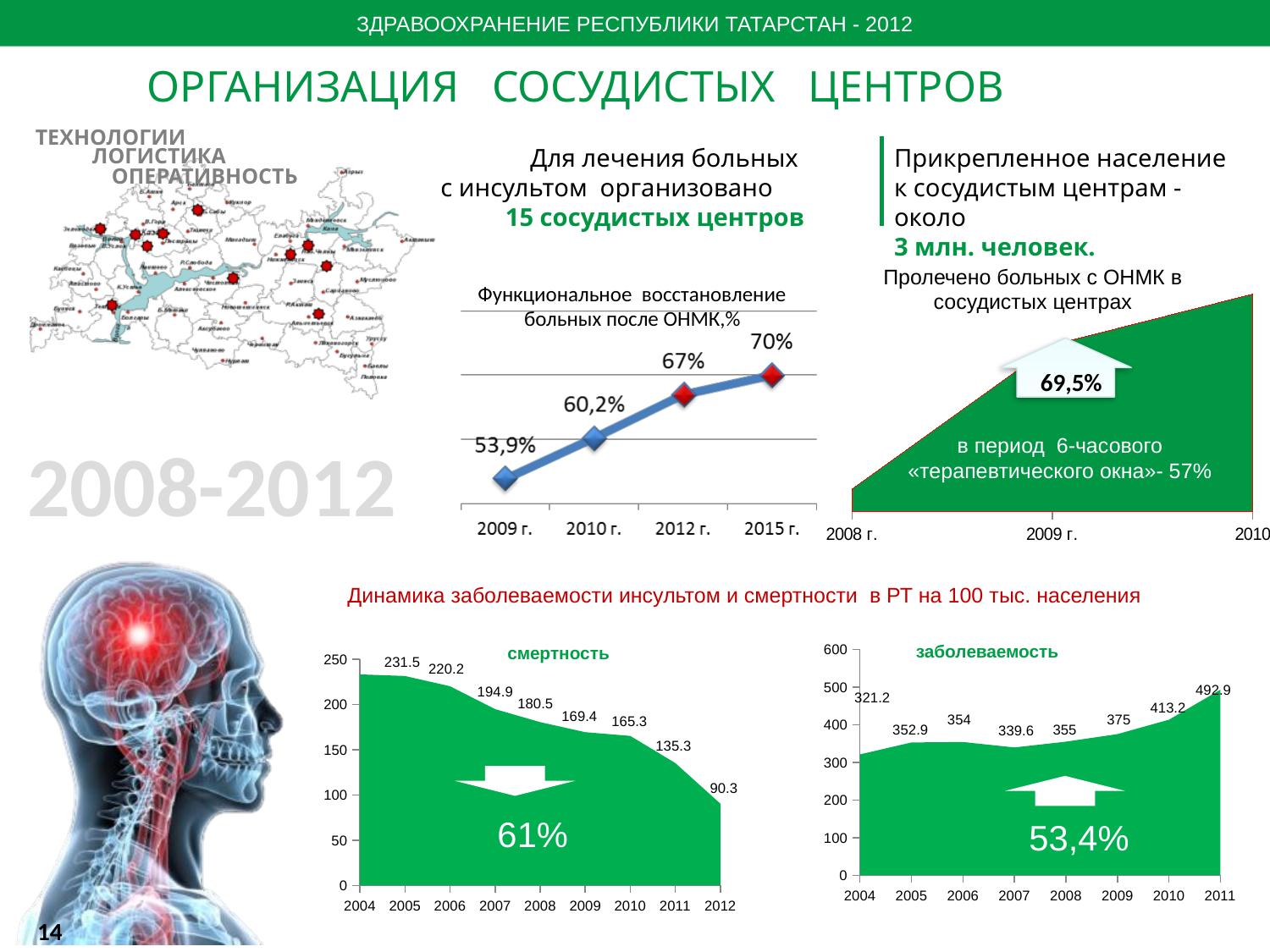
In the 'смертность' chart, what is the value for 2012? 90.3 In the 'заболеваемость' chart, what is the difference between the values for 2011 and 2010? 79.7 In the chart 'Функциональное восстановление больных после ОНМК,%', how many data points are plotted? 4 In the 'заболеваемость' chart, what is the value for 2011? 492.9 In the chart 'Функциональное восстановление больных после ОНМК,%', do the values rise or fall from 2009 г. to 2015 г.? rise In the 'заболеваемость' chart, which year has the highest value? 2011 In the chart 'Функциональное восстановление больных после ОНМК,%', what is the value for 2009 г.? 53,9% In the chart 'Функциональное восстановление больных после ОНМК,%', what kind of chart is it? line chart In the 'смертность' chart, what is the lowest labelled value? 90.3 In the 'заболеваемость' chart, what is the value for 2004? 321.2 In the 'смертность' chart, do the values rise or fall along the x axis from 2004 to 2012? fall In the chart 'Функциональное восстановление больных после ОНМК,%', what is the value for 2015 г.? 70%